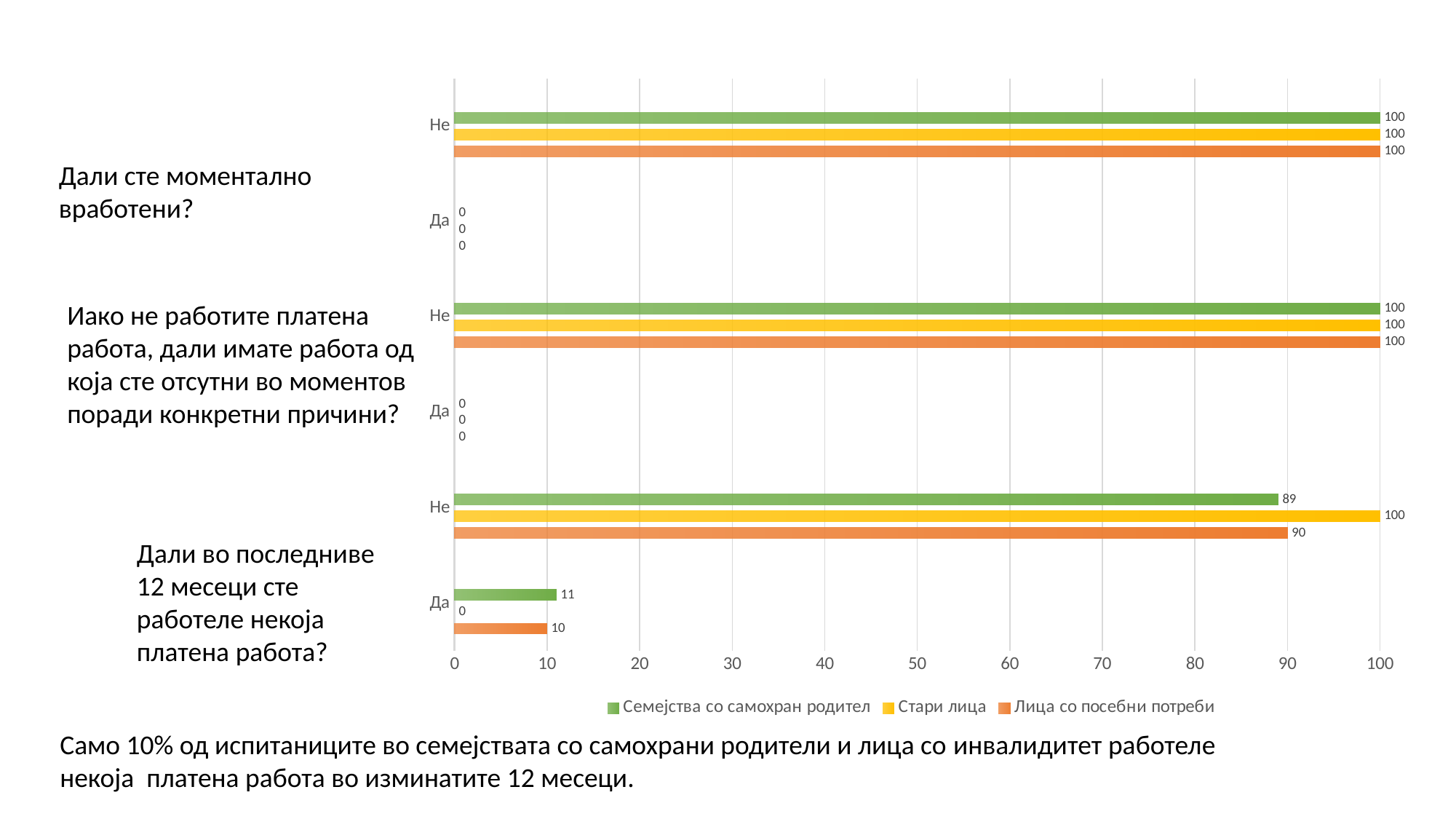
Which colour represents the series Лица со посебни потреби in the legend? orange What kind of chart is shown on the slide? bar chart For the question "Дали во последниве 12 месеци сте работеле некоја платена работа?", which series has the highest value for "Не"? Стари лица For the question "Дали во последниве 12 месеци сте работеле некоја платена работа?", which is larger for "Да": Семејства со самохран родител or Лица со посебни потреби? Семејства со самохран родител For the question "Дали во последниве 12 месеци сте работеле некоја платена работа?", what is the value for "Не" for Семејства со самохран родител? 89 How many series does the legend list? 3 For the question "Дали во последниве 12 месеци сте работеле некоја платена работа?", what is the value for "Не" for Стари лица? 100 For the question "Дали во последниве 12 месеци сте работеле некоја платена работа?", what is the value for "Да" for Семејства со самохран родител? 11 For the question "Дали сте моментално вработени?", what is the value for "Да" for Стари лица? 0 For the question "Дали во последниве 12 месеци сте работеле некоја платена работа?", what is the value for "Да" for Лица со посебни потреби? 10 For the question "Дали во последниве 12 месеци сте работеле некоја платена работа?", what is the difference between the "Не" values for Стари лица and Семејства со самохран родител? 11 For the question "Дали во последниве 12 месеци сте работеле некоја платена работа?", which series has the lowest value for "Да"? Стари лица